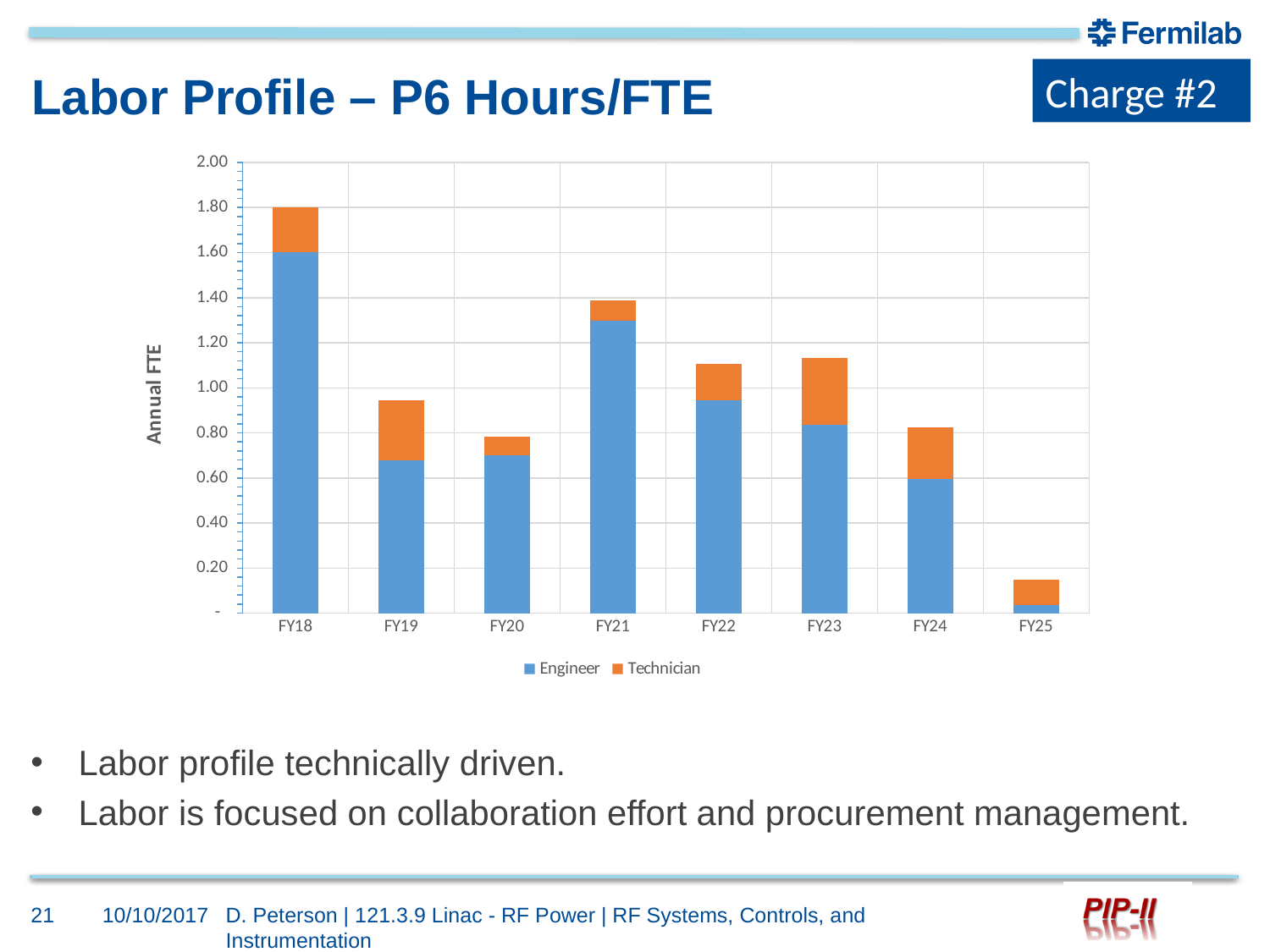
Which has the larger total Annual FTE, FY21 or FY22? FY21 Which has the larger total Annual FTE, FY19 or FY20? FY19 Is the total Annual FTE for FY21 greater or less than 1.20? greater Which fiscal year has the lowest total Annual FTE? FY25 Is the total Annual FTE for FY25 greater or less than 0.20? less Is the total Annual FTE for FY18 greater or less than 1.60? greater How many fiscal years are shown on the x axis of the chart? 8 How many series does the chart legend list? 2 What kind of chart is shown on the slide? Stacked bar chart Which fiscal year has the highest total Annual FTE? FY18 What is the label of the y axis of the chart? Annual FTE